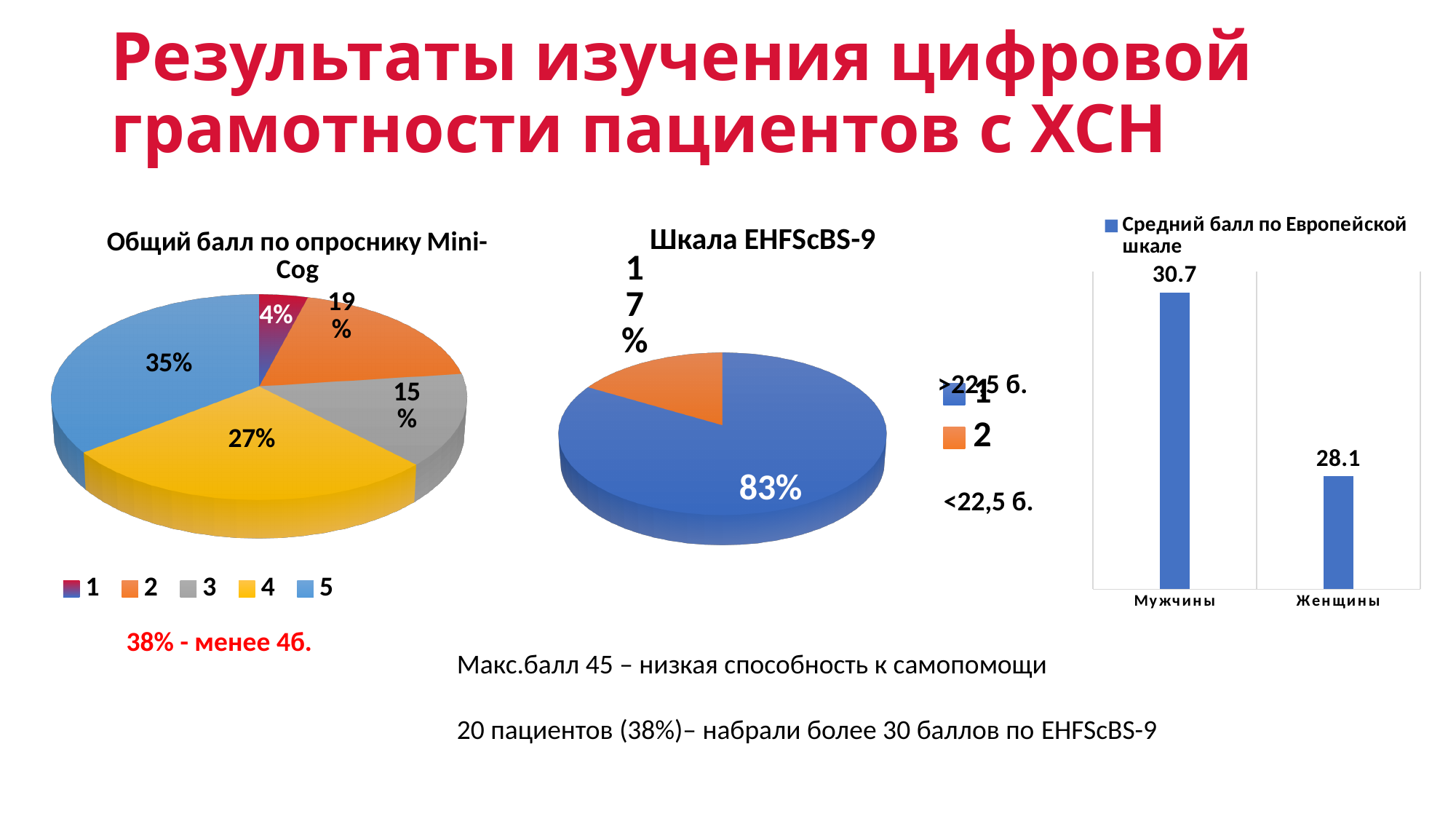
What type of chart is 'Шкала EHFScBS-9'? Pie chart In the 'Общий балл по опроснику Mini-Cog' pie chart, what share does category 4 have? 27% In the 'Средний балл по Европейской шкале' chart, what is the value for Мужчины? 30.7 In the 'Общий балл по опроснику Mini-Cog' pie chart, how many categories does the legend list? 5 In the 'Шкала EHFScBS-9' pie chart, what share does category 1 have? 83% In the 'Средний балл по Европейской шкале' chart, what is the difference between the values for Мужчины and Женщины? 2.6 In the 'Общий балл по опроснику Mini-Cog' pie chart, which category has the smallest slice? 1 In the 'Общий балл по опроснику Mini-Cog' pie chart, what is the difference between the shares of category 2 and category 3? 4% What type of chart is 'Средний балл по Европейской шкале'? Bar chart In the 'Общий балл по опроснику Mini-Cog' pie chart, which category has the largest slice? 5 In the 'Общий балл по опроснику Mini-Cog' pie chart, what share does category 5 have? 35% In the 'Шкала EHFScBS-9' pie chart, what share does category 2 have? 17%